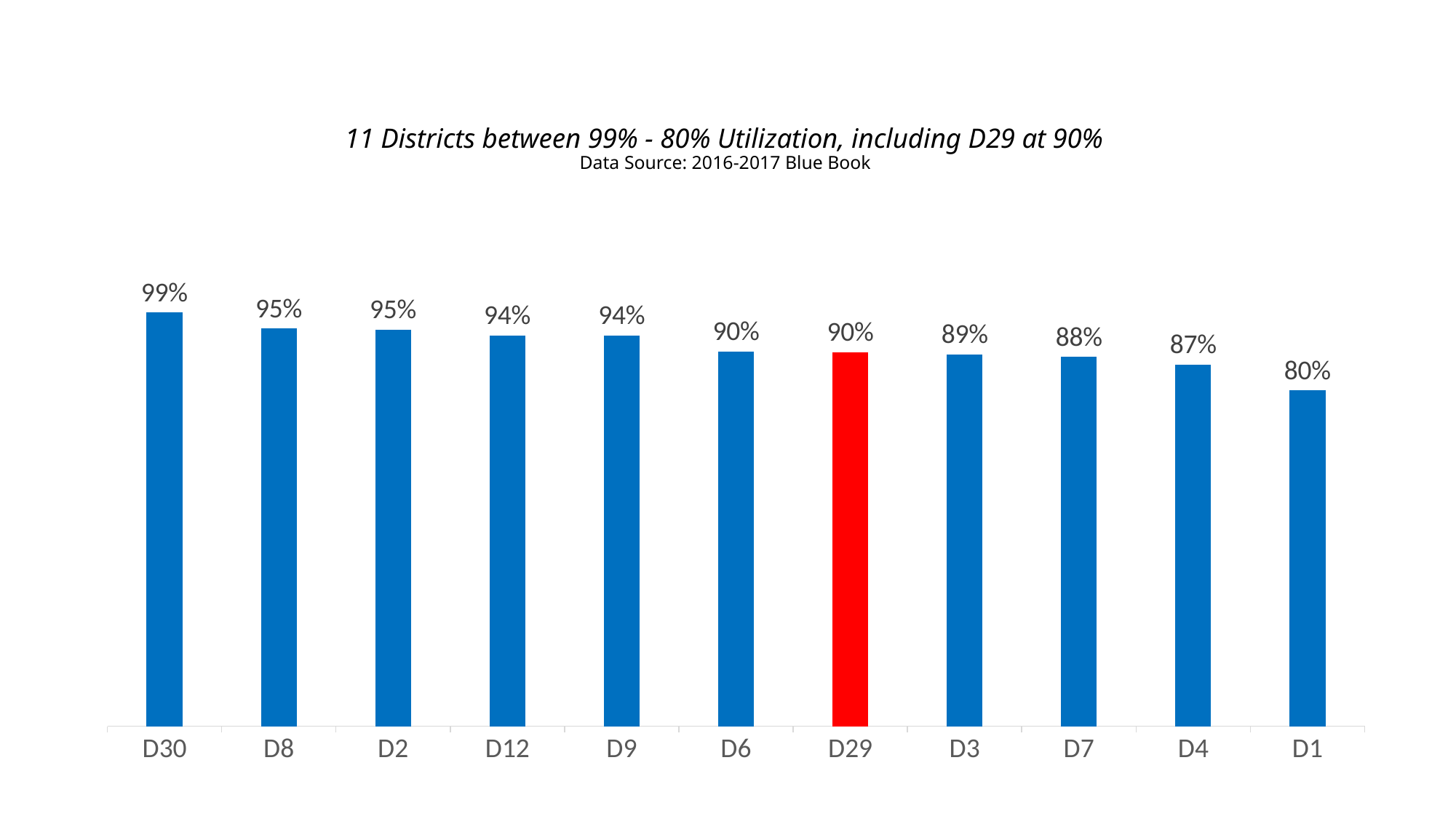
What is the utilization value for D4? 87% Which district's bar is coloured red? D29 What is the difference between the utilization of D8 and D3? 6% What kind of chart is shown on the slide? Bar chart Which district has the lowest utilization? D1 Do the values rise or fall from left to right along the x axis? Fall What is the difference between the utilization of D30 and D1? 19% Which has a higher utilization, D7 or D2? D2 What is the utilization value for D12? 94% What is the utilization value for D29? 90% Which district has the highest utilization? D30 How many districts are shown in the chart? 11